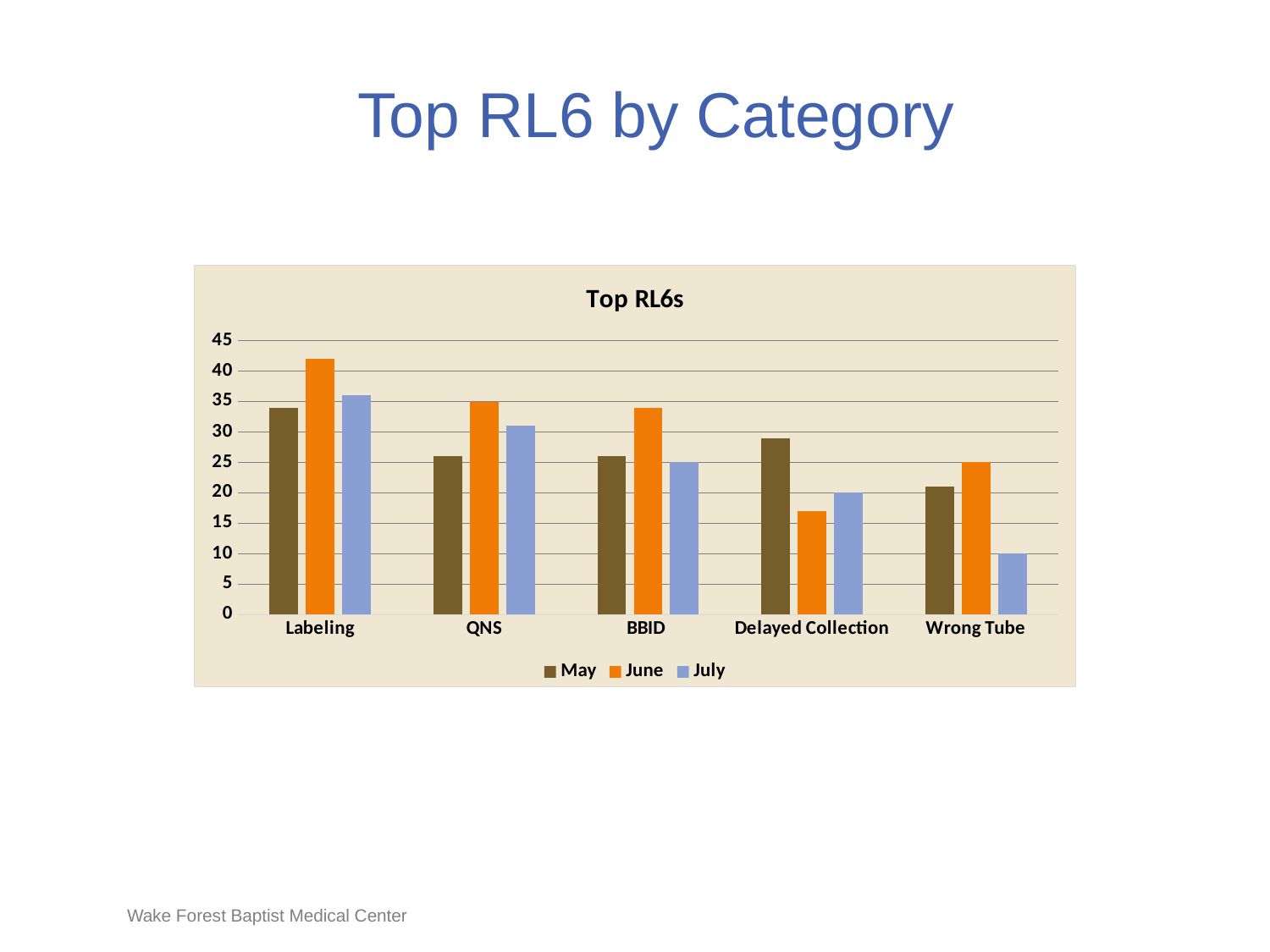
How many categories are shown on the x axis? 5 Which is larger for Delayed Collection, the May value or the June value? May What kind of chart is shown on the slide? bar chart Which series is shown in orange? June Is the June value for Labeling greater or less than 40? greater How many series does the legend list? 3 Which is larger for QNS, the June value or the July value? June Is the May value for Delayed Collection greater or less than 25? greater Is the June value for Delayed Collection greater or less than 20? less What is the title shown inside the chart area? Top RL6s Which category has the highest June value? Labeling Which category has the lowest July value? Wrong Tube